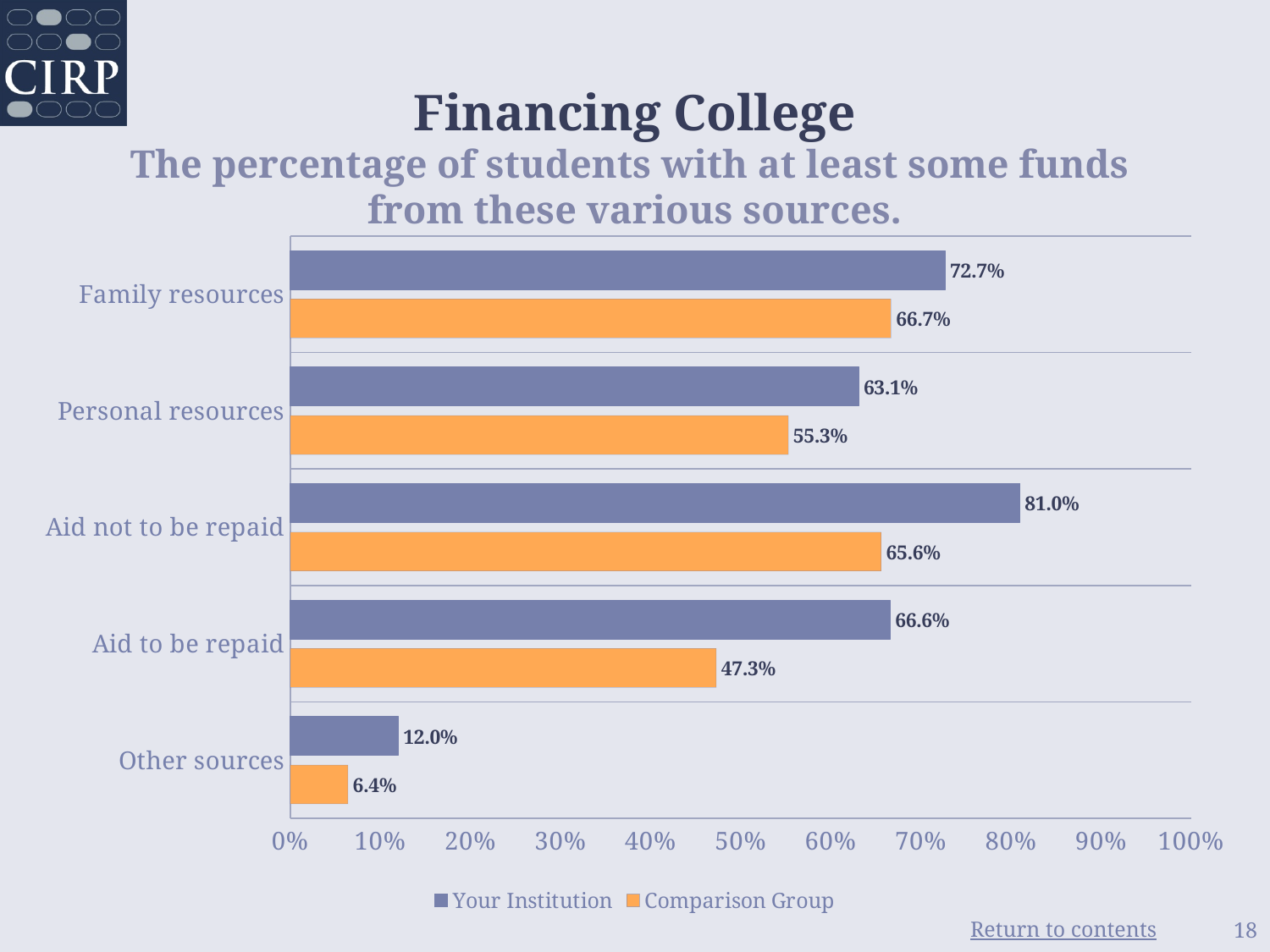
What is the difference between Your Institution and Comparison Group for Personal resources? 7.8% What kind of chart is shown on the slide? Bar chart Which category has the highest value for Your Institution? Aid not to be repaid What is the value for Your Institution for Family resources? 72.7% Which category has the lowest value for Comparison Group? Other sources What is the value for Comparison Group for Aid to be repaid? 47.3% How many series does the legend list? 2 Which is larger for Aid to be repaid: Your Institution or Comparison Group? Your Institution How many categories are shown on the chart? 5 What is the difference between Your Institution and Comparison Group for Aid not to be repaid? 15.4% What is the value for Comparison Group for Other sources? 6.4% What colour are the Comparison Group bars? Orange